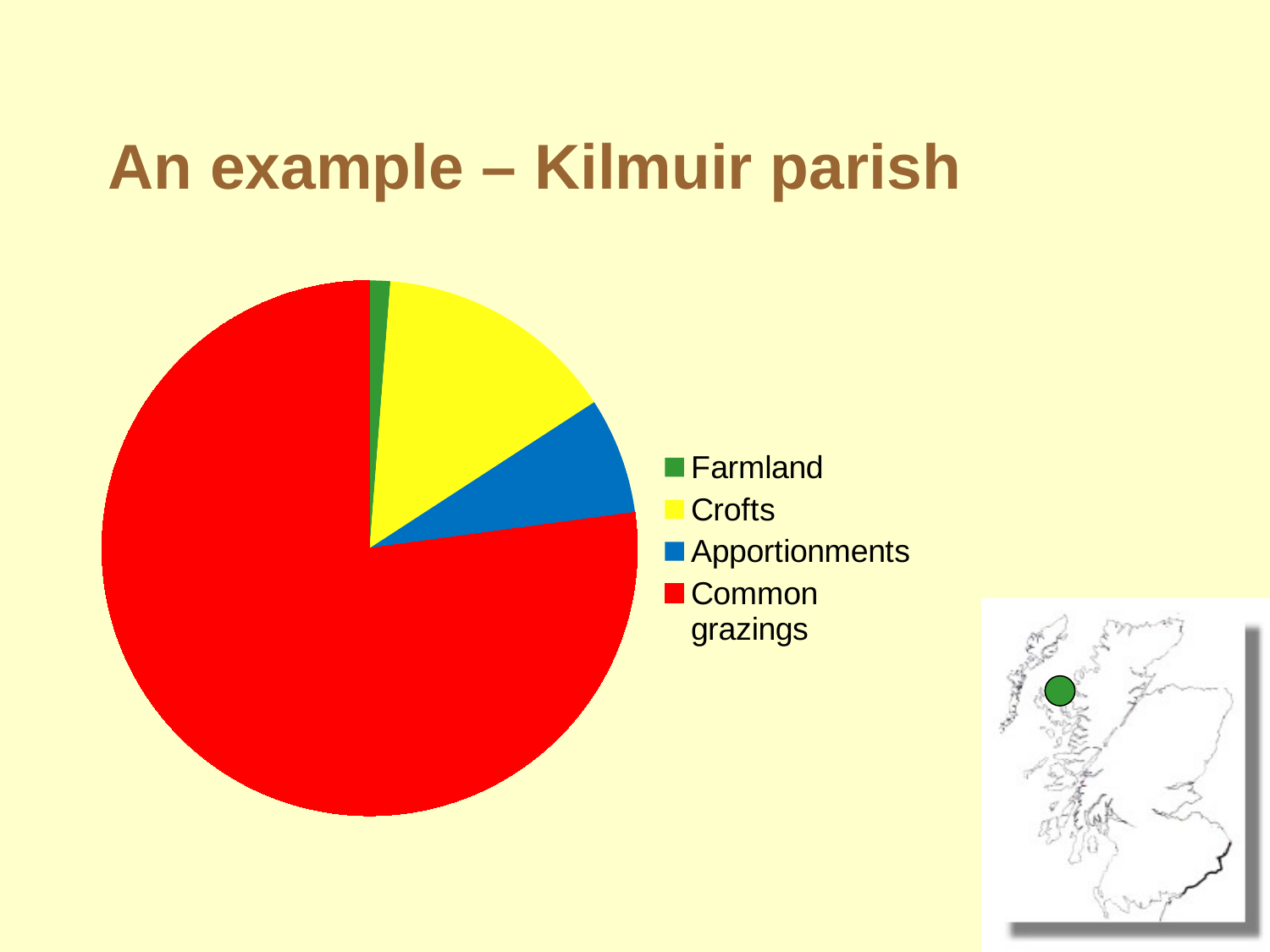
Which category is shown in red in the pie chart? Common grazings What kind of chart is shown on the slide? pie chart Which category has the smallest slice of the pie chart? Farmland How many categories does the pie chart have? 4 Which slice is larger in the pie chart, Common grazings or Crofts? Common grazings What colour is the Crofts slice in the pie chart? yellow Which slice is larger in the pie chart, Apportionments or Farmland? Apportionments Which category has the largest slice of the pie chart? Common grazings How many entries does the legend of the pie chart list? 4 Which slice is larger in the pie chart, Crofts or Apportionments? Crofts